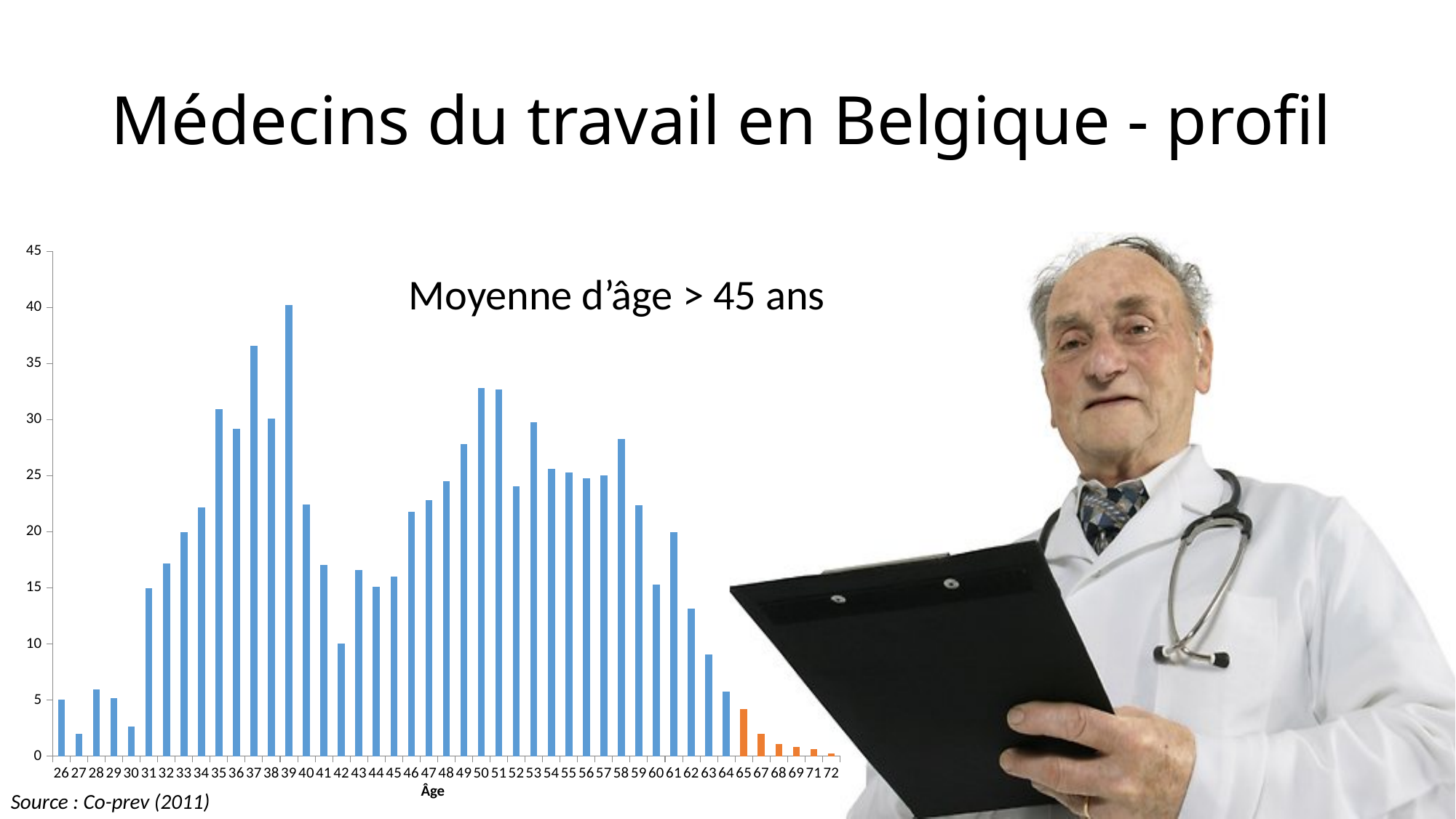
Is the value for age 50 greater or less than 30? greater Is the value for age 58 greater or less than 25? greater Is the value for age 42 greater or less than 15? less Which age has the highest bar in the chart? 39 Which age has the lowest bar in the chart? 72 Which has the larger value, age 39 or age 37? 39 Which has the larger value, age 43 or age 42? 43 What kind of chart is shown on the slide? bar chart Do the values rise or fall along the x axis from age 58 to age 72? fall What is the title of the x axis of the chart? Âge